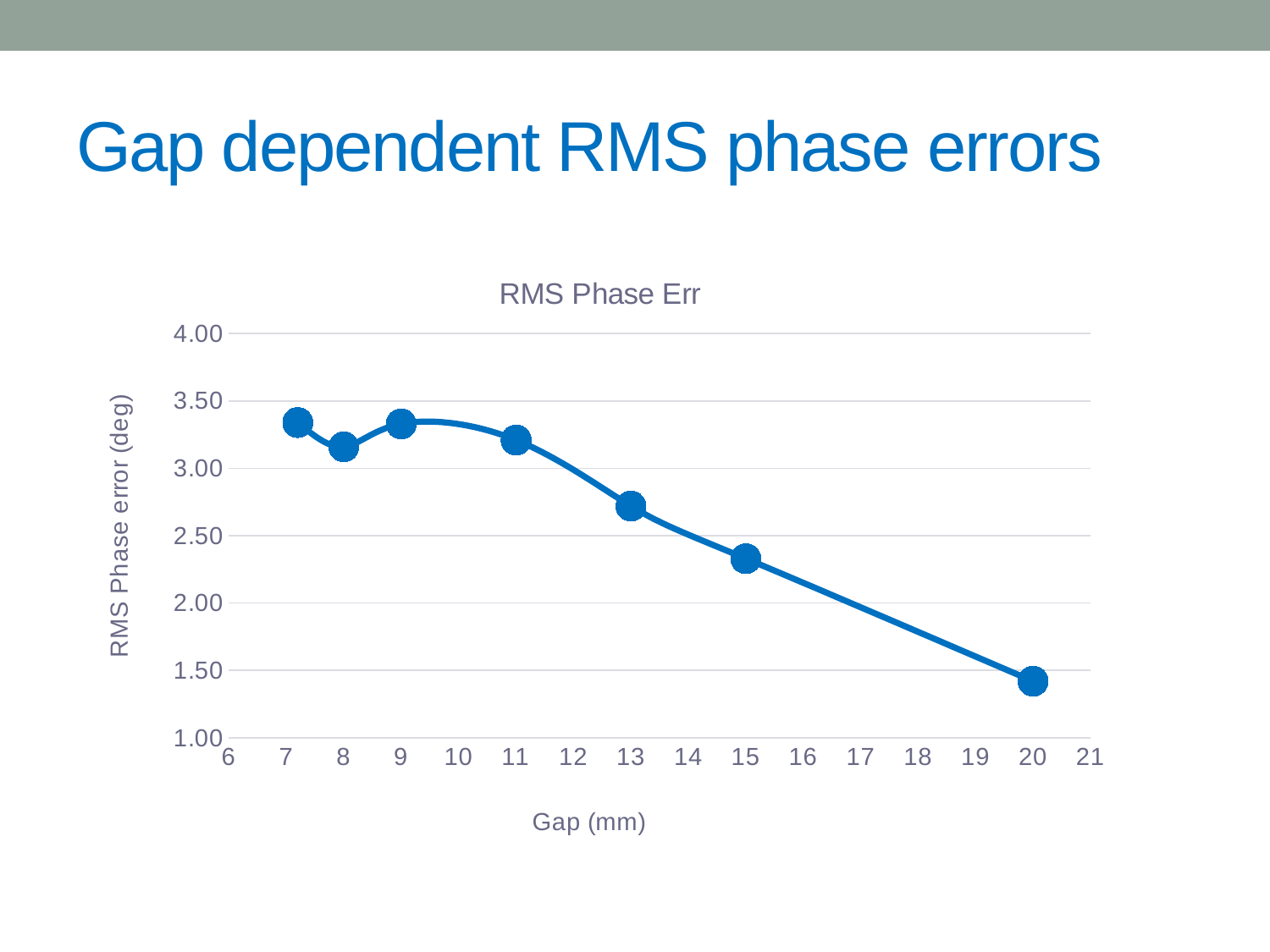
Is the RMS phase error at a gap of 13 mm greater or less than 2.50? greater Which has a larger RMS phase error: a gap of 13 mm or a gap of 20 mm? 13 mm Is the RMS phase error at a gap of 15 mm greater or less than 2.50? less Is the RMS phase error at a gap of 20 mm greater or less than 2.00? less What is the label of the x axis? Gap (mm) What is the title of the chart? RMS Phase Err At which gap value is the RMS phase error lowest? 20 What kind of chart is shown on the slide? line chart How many data points are plotted on the chart? 7 Overall, does the RMS phase error rise or fall as the gap increases from 11 mm to 20 mm? fall